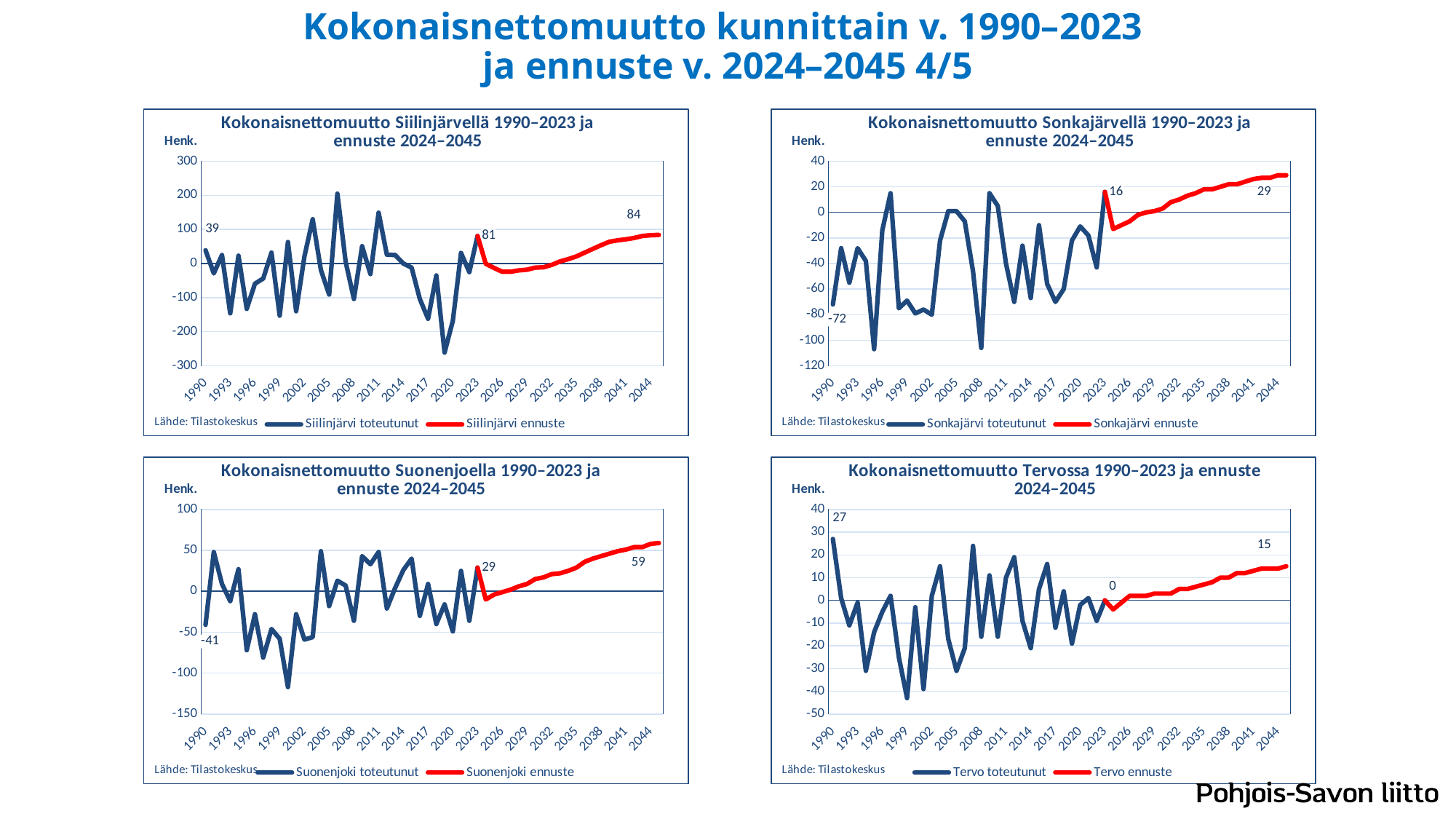
In the Tervo chart (bottom right), which is larger: the 1990 value or the 2045 value? 1990 value (27) In the Suonenjoki chart (bottom left), what is the difference between the 2045 value (59) and the 2023 value (29)? 30 In the Siilinjärvi chart (top left), what is the labelled value at the end of the forecast in 2045? 84 How many series does the legend of the Siilinjärvi chart (top left) list? 2 In the Suonenjoki chart (bottom left), what is the labelled value for 2045? 59 In the Sonkajärvi chart (top right), what is the labelled value for 1990? -72 In the Sonkajärvi chart (top right), what is the labelled value for 2023? 16 In the Sonkajärvi chart (top right), does the red forecast line rise or fall from 2024 to 2045? rise What kind of chart is the Tervo chart (bottom right)? line chart In the Siilinjärvi chart (top left), is the lowest point of the actual (blue) line around 2020 greater or less than -200? less In the Tervo chart (bottom right), what is the labelled value for 2023? 0 In the Siilinjärvi chart (top left), what is the labelled value for 1990? 39